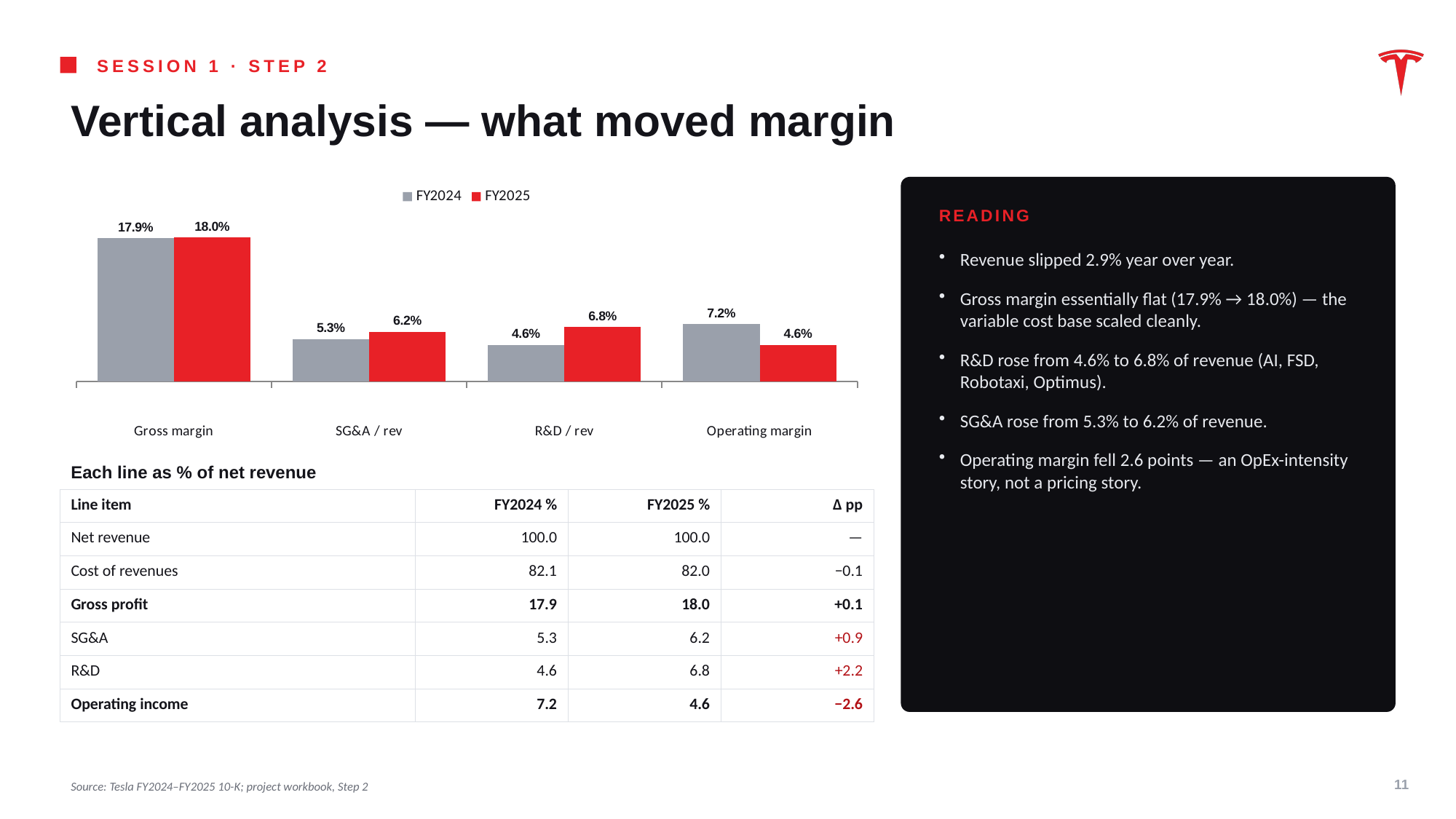
What is the FY2025 value for Gross margin in the chart? 18.0% For SG&A / rev, which is larger: the FY2024 value or the FY2025 value? FY2025 Which colour represents FY2025 in the chart? Red What is the FY2024 value for R&D / rev in the chart? 4.6% How many categories are shown on the x axis of the chart? 4 Which category has the lowest FY2025 value in the chart? Operating margin What kind of chart is shown on the slide? Bar chart How many series does the chart legend list? 2 What is the FY2025 value for Operating margin in the chart? 4.6% Which category has the highest FY2024 value in the chart? Gross margin For Operating margin, which is larger: the FY2024 value or the FY2025 value? FY2024 What is the difference between the FY2025 and FY2024 values for R&D / rev? 2.2 percentage points